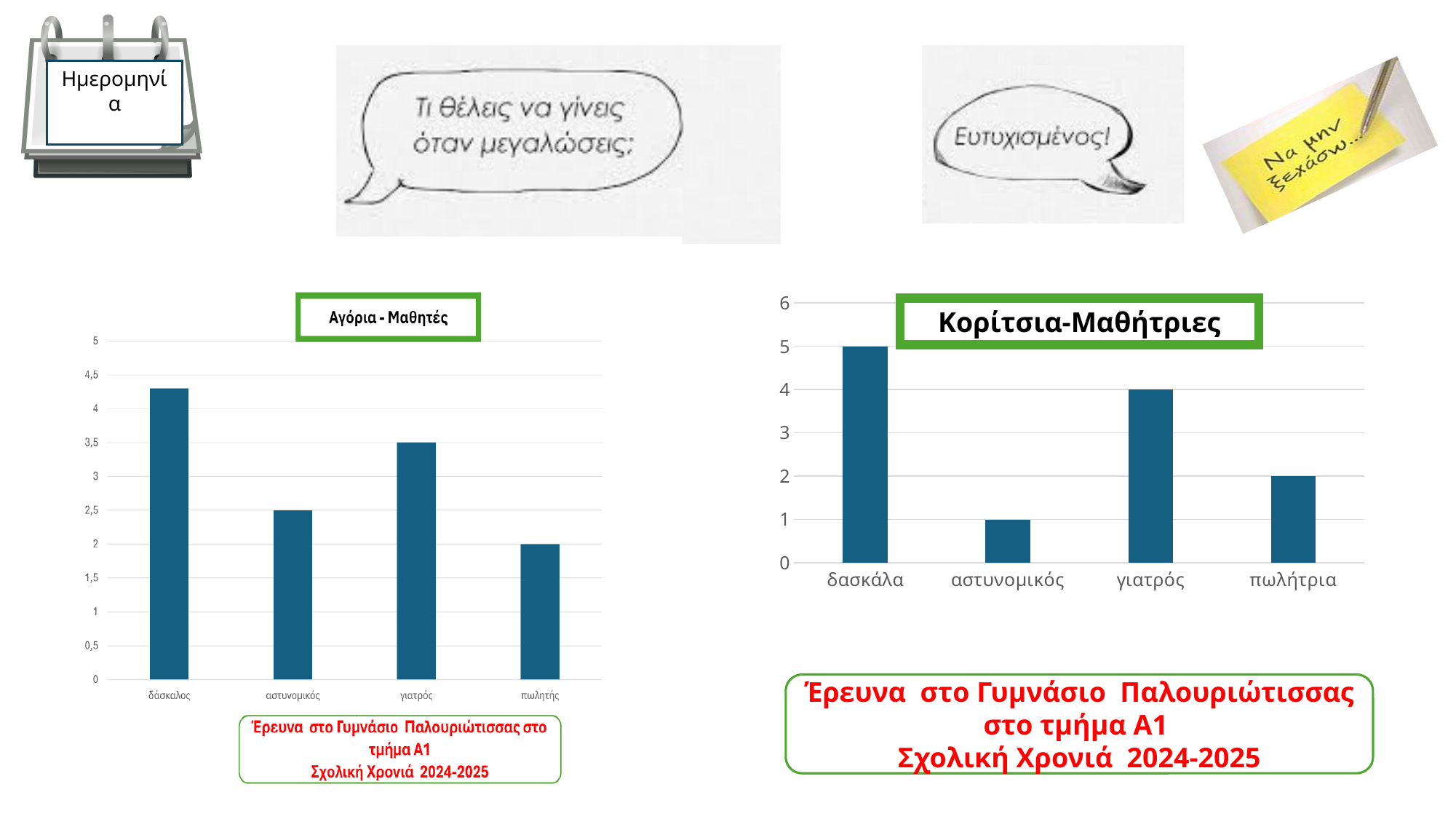
In the chart titled Αγόρια - Μαθητές, what is the value for πωλητής? 2 In the chart titled Κορίτσια-Μαθήτριες, what is the value for γιατρός? 4 What kind of chart is the chart titled Κορίτσια-Μαθήτριες? bar chart In the chart titled Αγόρια - Μαθητές, is the value for δάσκαλος greater or less than 4? greater In the chart titled Αγόρια - Μαθητές, which is larger, the value for αστυνομικός or the value for γιατρός? γιατρός In the chart titled Κορίτσια-Μαθήτριες, which category has the lowest value? αστυνομικός In the chart titled Κορίτσια-Μαθήτριες, what is the difference between the values for δασκάλα and πωλήτρια? 3 In the chart titled Κορίτσια-Μαθήτριες, what is the value for αστυνομικός? 1 In the chart titled Αγόρια - Μαθητές, what is the value for γιατρός? 3,5 How many categories are shown in the chart titled Αγόρια - Μαθητές? 4 In the chart titled Κορίτσια-Μαθήτριες, which category has the highest value? δασκάλα In the chart titled Κορίτσια-Μαθήτριες, what is the value for δασκάλα? 5